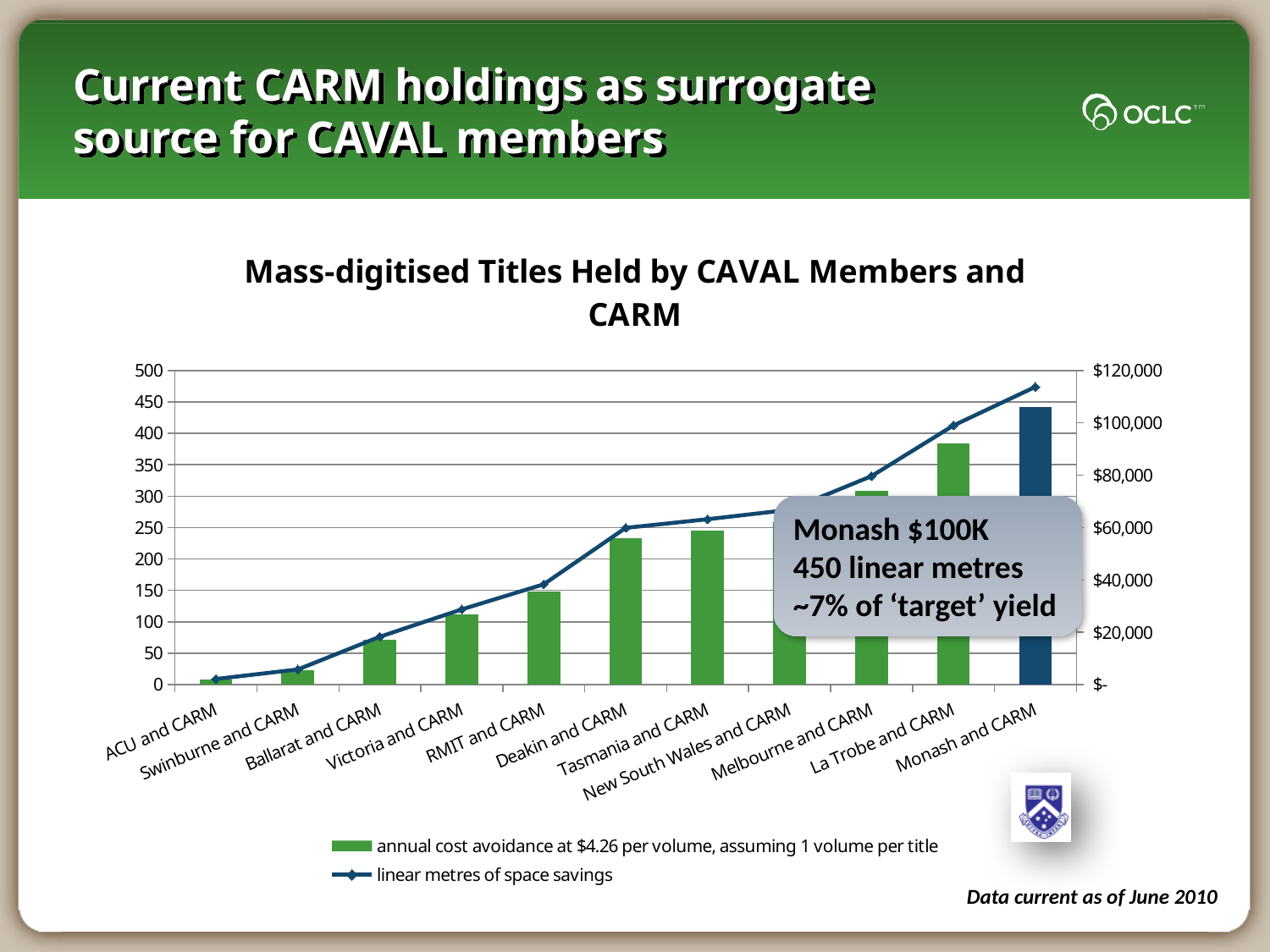
Is the bar for Monash and CARM greater or less than 400 on the left axis scale? greater Is the bar for Deakin and CARM greater or less than 200 on the left axis scale? greater Which has the taller bar, Melbourne and CARM or Deakin and CARM? Melbourne and CARM Which category has the tallest bar in the chart? Monash and CARM What is the title of the chart? Mass-digitised Titles Held by CAVAL Members and CARM How many series does the chart legend list? 2 Which category has the shortest bar in the chart? ACU and CARM What kind of chart is shown on the slide? A combined bar and line chart Is the bar for ACU and CARM greater or less than 50 on the left axis scale? less How many categories are shown along the x axis of the chart? 11 Do the values of the line series rise or fall moving from left to right along the x axis? Rise